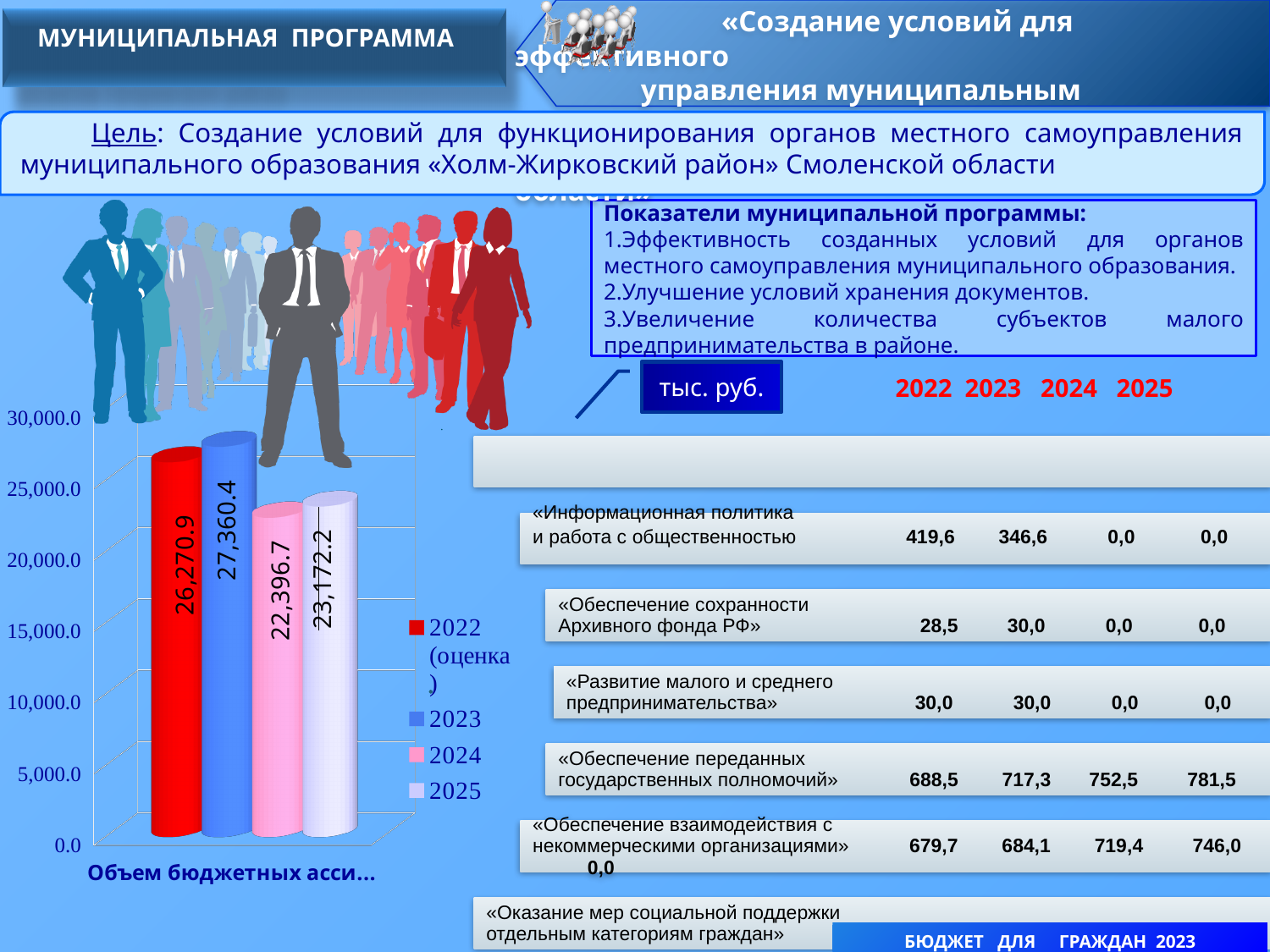
Which year has the lowest bar in the bar chart? 2024 What is the value of the bar for 2024 in the bar chart? 22,396.7 What is the value of the bar for 2023 in the bar chart? 27,360.4 What is the value of the bar for 2025 in the bar chart? 23,172.2 Is the value for 2024 in the bar chart greater or less than 25,000.0? less Which year has the highest bar in the bar chart? 2023 What is the difference between the 2023 and 2024 values in the bar chart? 4,963.7 What is the value of the bar for 2022 (оценка) in the bar chart? 26,270.9 How many bars are plotted in the bar chart? 4 What type of chart is shown on the left of the slide? bar chart Which is larger in the bar chart, the value for 2022 (оценка) or the value for 2025? 2022 (оценка) How many entries does the legend of the bar chart list? 4